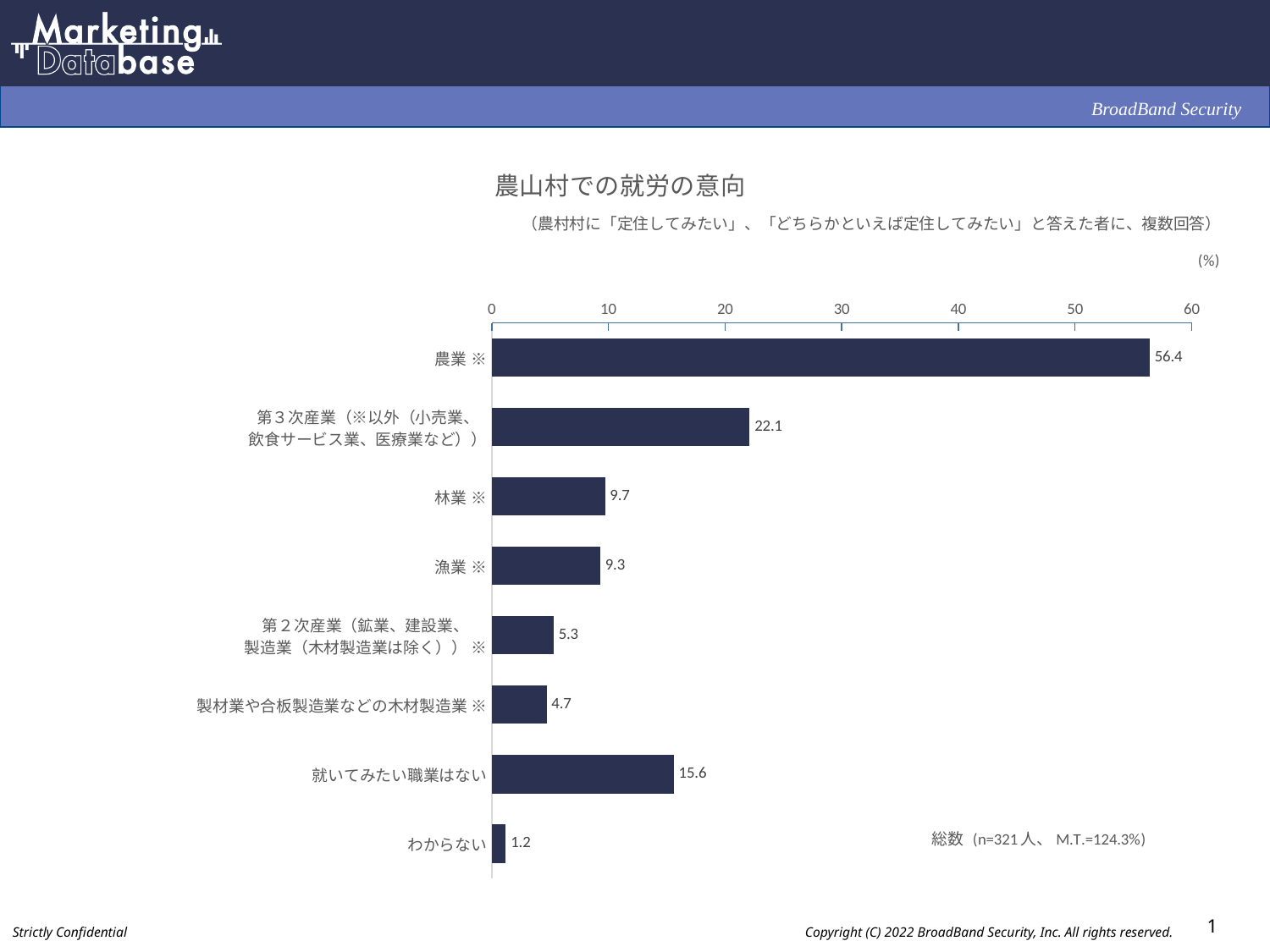
Which category has the highest value? 農業 ※ Which category has the lowest value? わからない Which is larger, the value for 漁業 ※ or the value for 第２次産業（鉱業、建設業、製造業（木材製造業は除く）） ※? 漁業 ※ What is the value for 製材業や合板製造業などの木材製造業 ※? 4.7 What is the value for 就いてみたい職業はない? 15.6 What is the title of the chart? 農山村での就労の意向 Is the value for 第３次産業（※以外（小売業、飲食サービス業、医療業など）） greater or less than 20? greater What is the difference between the values for 農業 ※ and 第３次産業（※以外（小売業、飲食サービス業、医療業など））? 34.3 What is the value for 林業 ※? 9.7 What kind of chart is shown on the slide? bar chart What is the value for 農業 ※? 56.4 How many categories are shown in the chart? 8